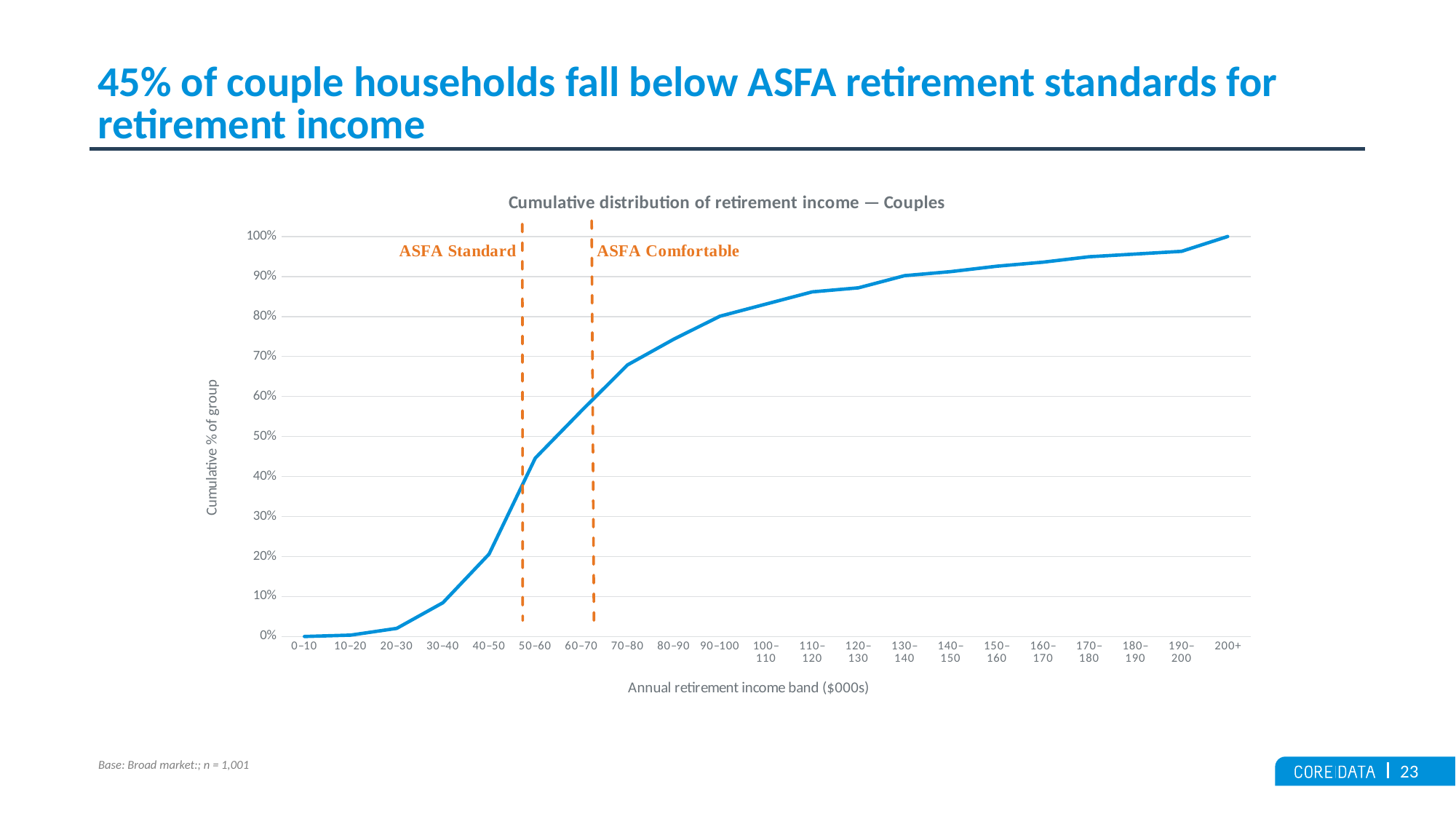
Do the values rise or fall as the income band increases along the x axis? rise Is the value for the 110–120 income band greater or less than 80%? greater Is the value for the 70–80 income band greater or less than 60%? greater Is the value for the 30–40 income band greater or less than 10%? less What is the title of the chart? Cumulative distribution of retirement income — Couples What kind of chart is shown on the slide? line chart Which income band has the lowest cumulative value? 0–10 How many income bands are shown along the x axis? 21 Which income band has the highest cumulative value? 200+ What is the cumulative value for the 200+ income band? 100% What are the labels on the two dashed vertical lines in the chart? ASFA Standard and ASFA Comfortable